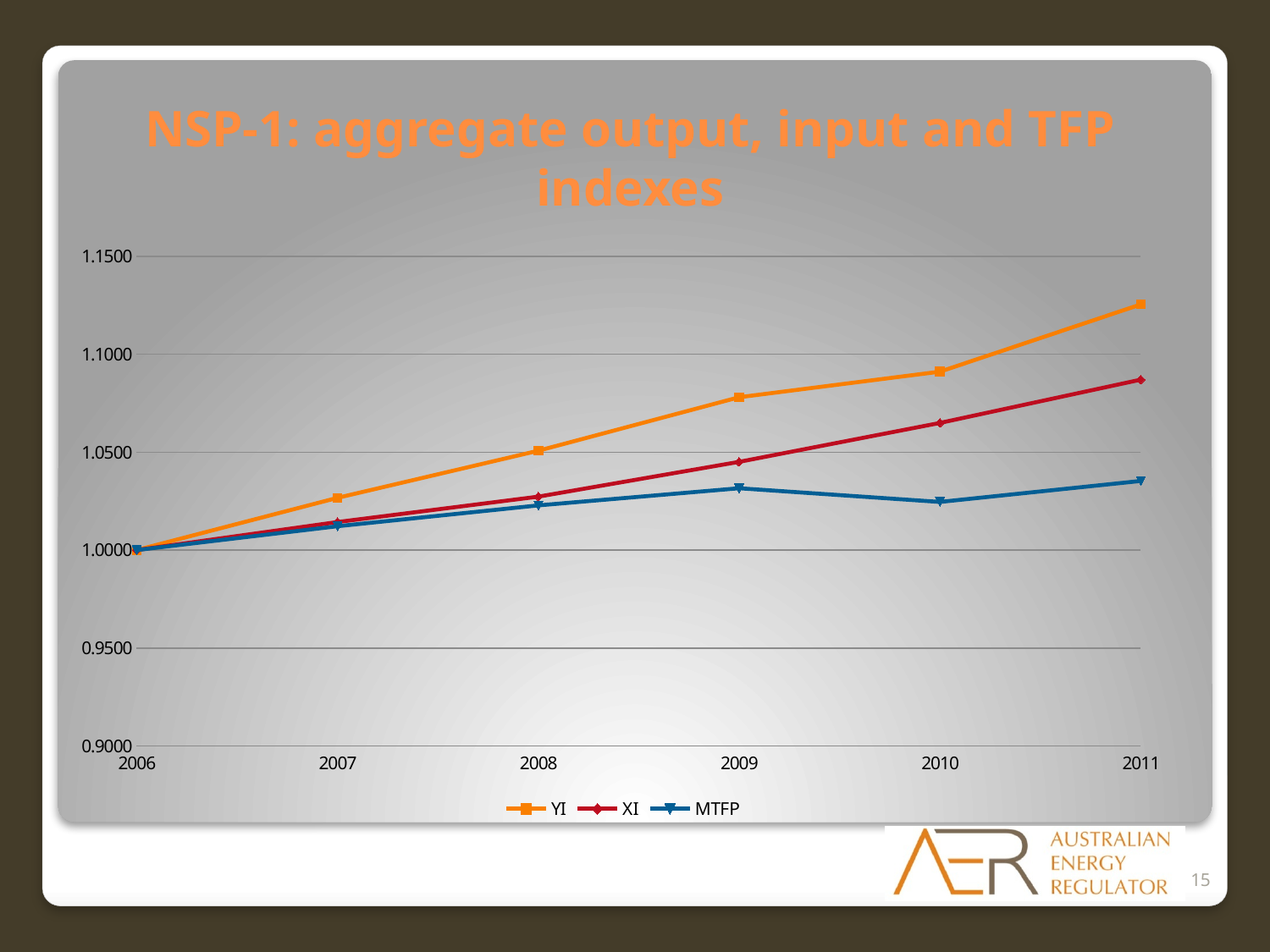
What is the title of the chart? NSP-1: aggregate output, input and TFP indexes Which series has the highest value in 2011? YI How many series does the legend list? 3 In 2010, which series has the larger value, YI or XI? YI What kind of chart is shown on the slide? line chart What is the value of the YI series in 2006? 1.0000 Is the value for YI in 2011 greater or less than 1.1000? greater Is the value for MTFP in 2010 greater or less than 1.0500? less Is the value for XI in 2011 greater or less than 1.1000? less Which series has the lowest value in 2011? MTFP How many years are plotted along the x axis? 6 Does the YI series rise or fall from 2006 to 2011? rise